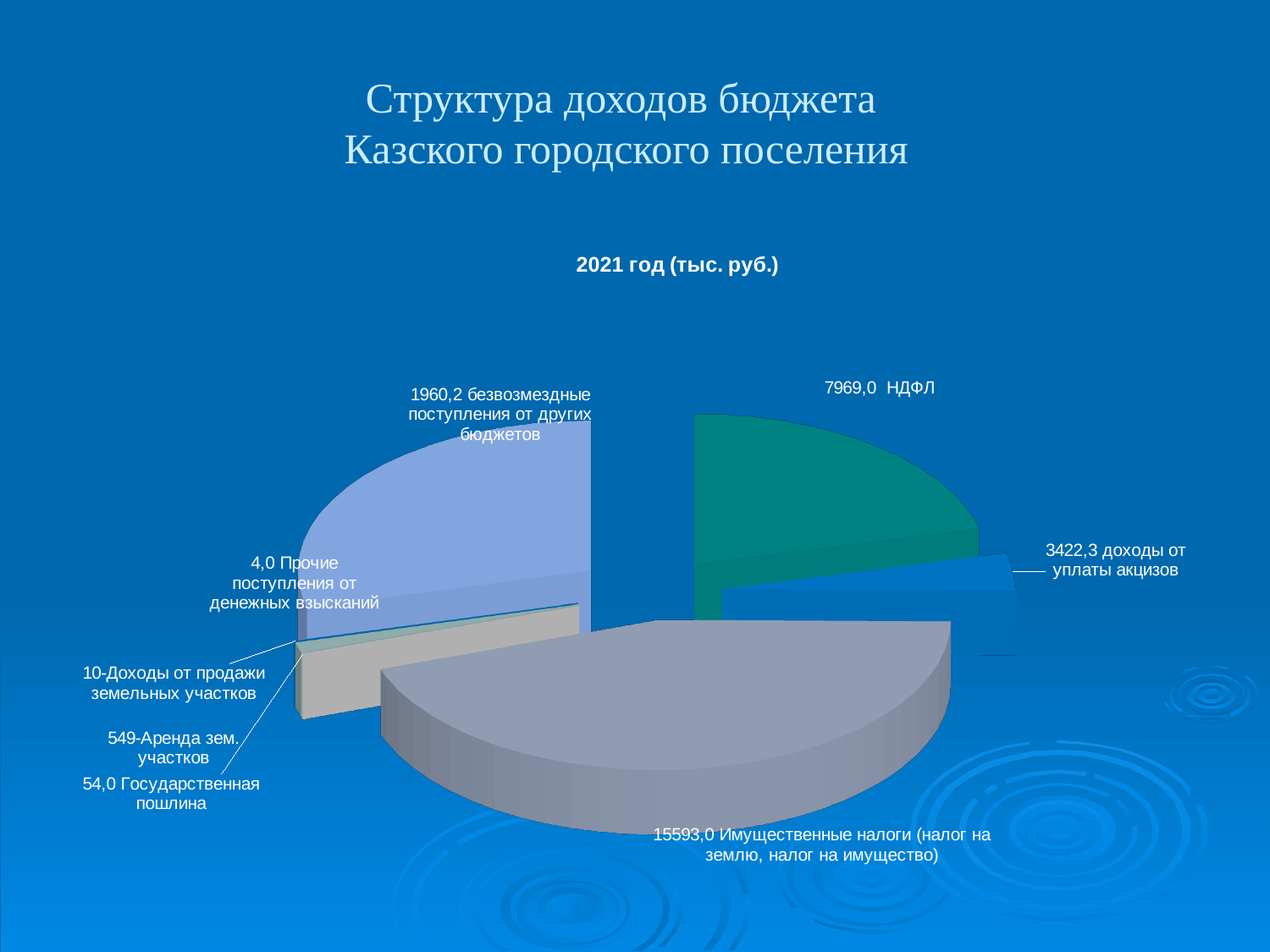
What is the value for Государственная пошлина? 54,0 What is the value for Имущественные налоги (налог на землю, налог на имущество)? 15593,0 What is the value for НДФЛ? 7969,0 Which category has the smallest value? Прочие поступления от денежных взысканий What is the title of the chart? 2021 год (тыс. руб.) What is the value for безвозмездные поступления от других бюджетов? 1960,2 What is the value for доходы от уплаты акцизов? 3422,3 What is the difference between Имущественные налоги and НДФЛ? 7624,0 Which is larger: НДФЛ or доходы от уплаты акцизов? НДФЛ What type of chart is shown on the slide? pie chart Which category has the largest value? Имущественные налоги (налог на землю, налог на имущество) How many categories are shown in the pie chart? 8